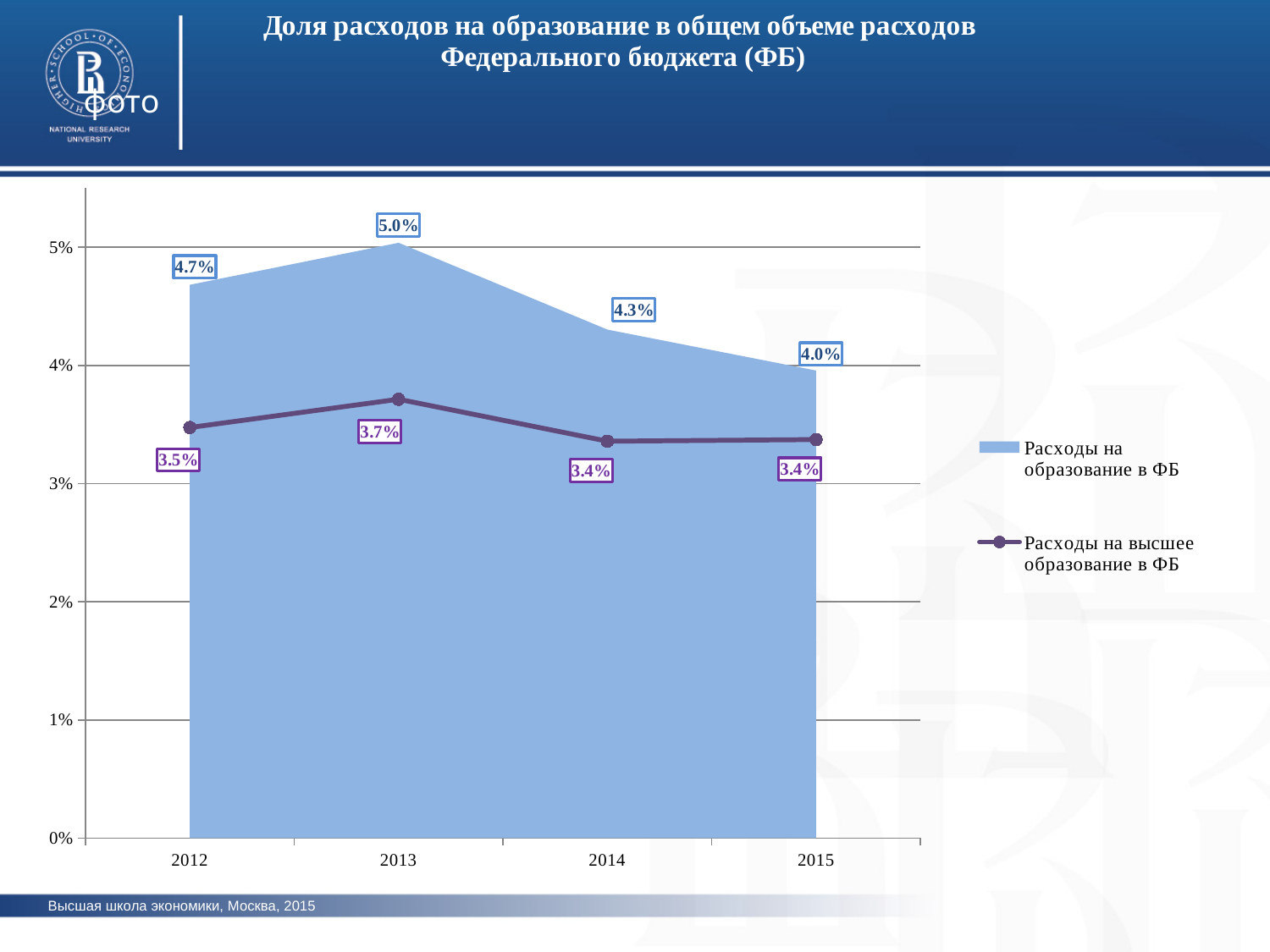
Which is larger: 'Расходы на образование в ФБ' in 2012 or in 2014? 2012 How many series does the legend list? 2 By how much did 'Расходы на образование в ФБ' fall from 2013 to 2015? 1.0% What is the difference between 'Расходы на образование в ФБ' and 'Расходы на высшее образование в ФБ' in 2014? 0.9% Does 'Расходы на образование в ФБ' rise or fall from 2013 to 2015? fall What is the value of 'Расходы на высшее образование в ФБ' in 2012? 3.5% What is the value of 'Расходы на образование в ФБ' in 2013? 5.0% In which year is 'Расходы на образование в ФБ' lowest? 2015 In which year is 'Расходы на образование в ФБ' highest? 2013 In which year is 'Расходы на высшее образование в ФБ' highest? 2013 What is the value of 'Расходы на образование в ФБ' in 2015? 4.0% How many years are shown on the x axis? 4